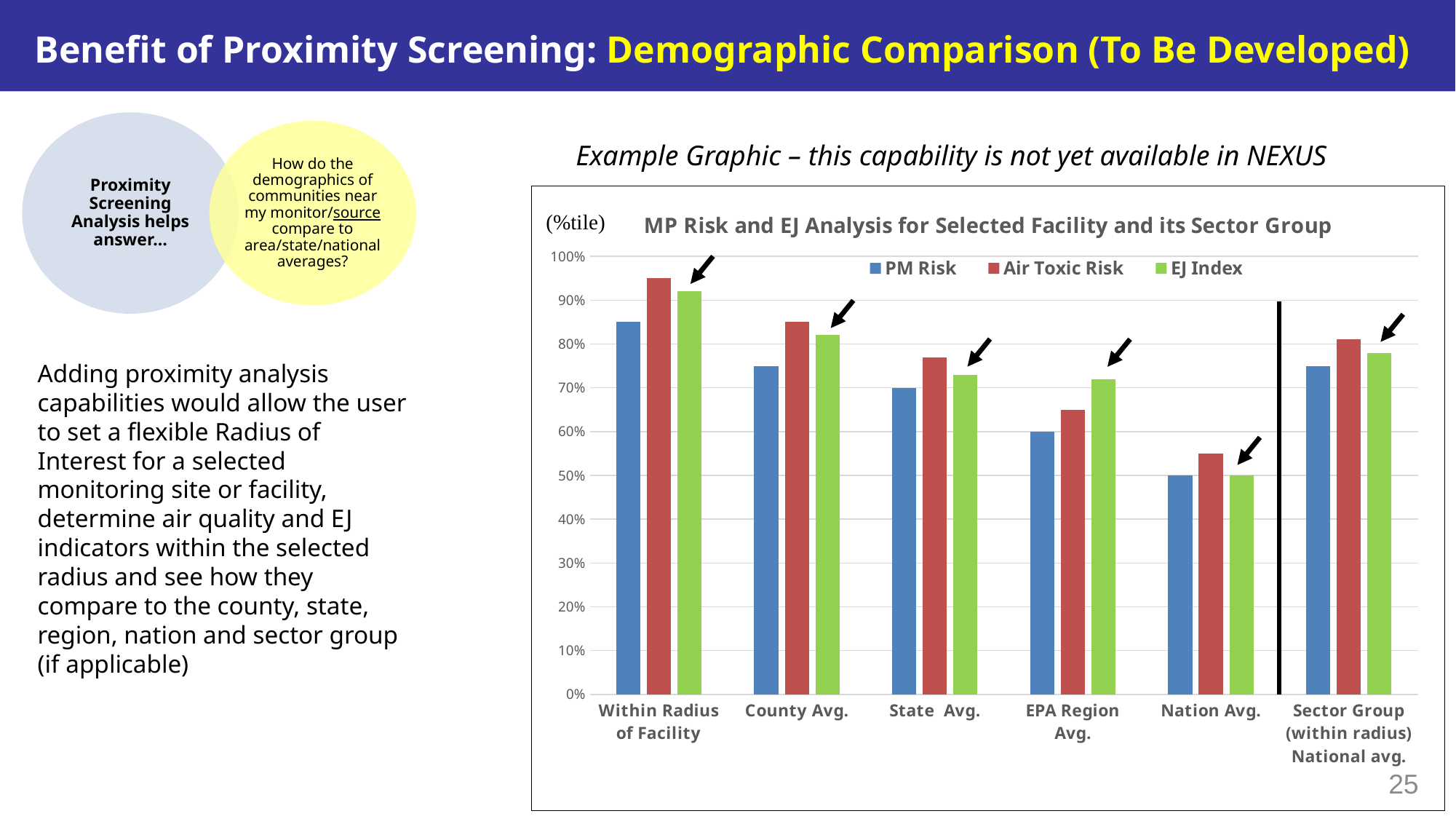
What type of chart is shown on the slide? bar chart How many series does the chart's legend list? 3 Which category has the lowest EJ Index value? Nation Avg. Which category has the highest Air Toxic Risk value? Within Radius of Facility Which is larger, the PM Risk value for Within Radius of Facility or for County Avg.? Within Radius of Facility Is the Air Toxic Risk value for Within Radius of Facility greater or less than 90%? greater Which series is shown in green in the chart? EJ Index What is the PM Risk value for EPA Region Avg.? 60% How many categories are shown along the x axis of the chart? 6 What is the PM Risk value for Nation Avg.? 50% What is the title of the chart? MP Risk and EJ Analysis for Selected Facility and its Sector Group Is the Air Toxic Risk value for State Avg. greater or less than 80%? less